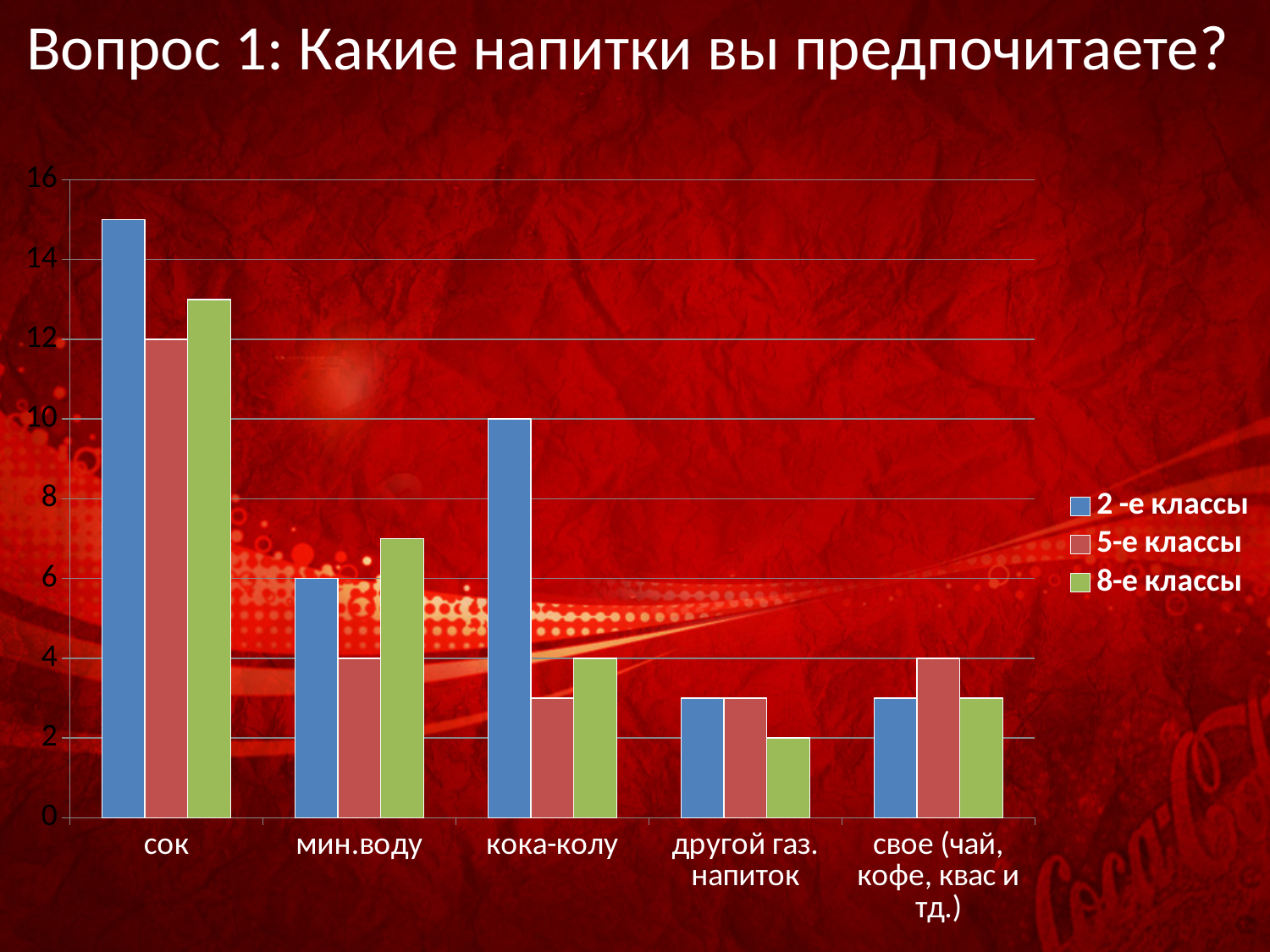
Is the value for 2-е классы in the сок category greater or less than 14? greater How many series does the legend list? 3 Which category has the highest value for 2-е классы? сок What kind of chart is shown on the slide? bar chart Is the value for 8-е классы in the мин.воду category greater or less than 6? greater How many drink categories are shown on the x axis? 5 What is the value for 2-е классы in the кока-колу category? 10 What is the value for 8-е классы in the другой газ. напиток category? 2 What is the value for 5-е классы in the сок category? 12 In the кока-колу category, which is larger: the value for 2-е классы or the value for 5-е классы? 2-е классы What is the difference between the 2-е классы value for кока-колу and the 2-е классы value for мин.воду? 4 What is the value for 2-е классы in the мин.воду category? 6